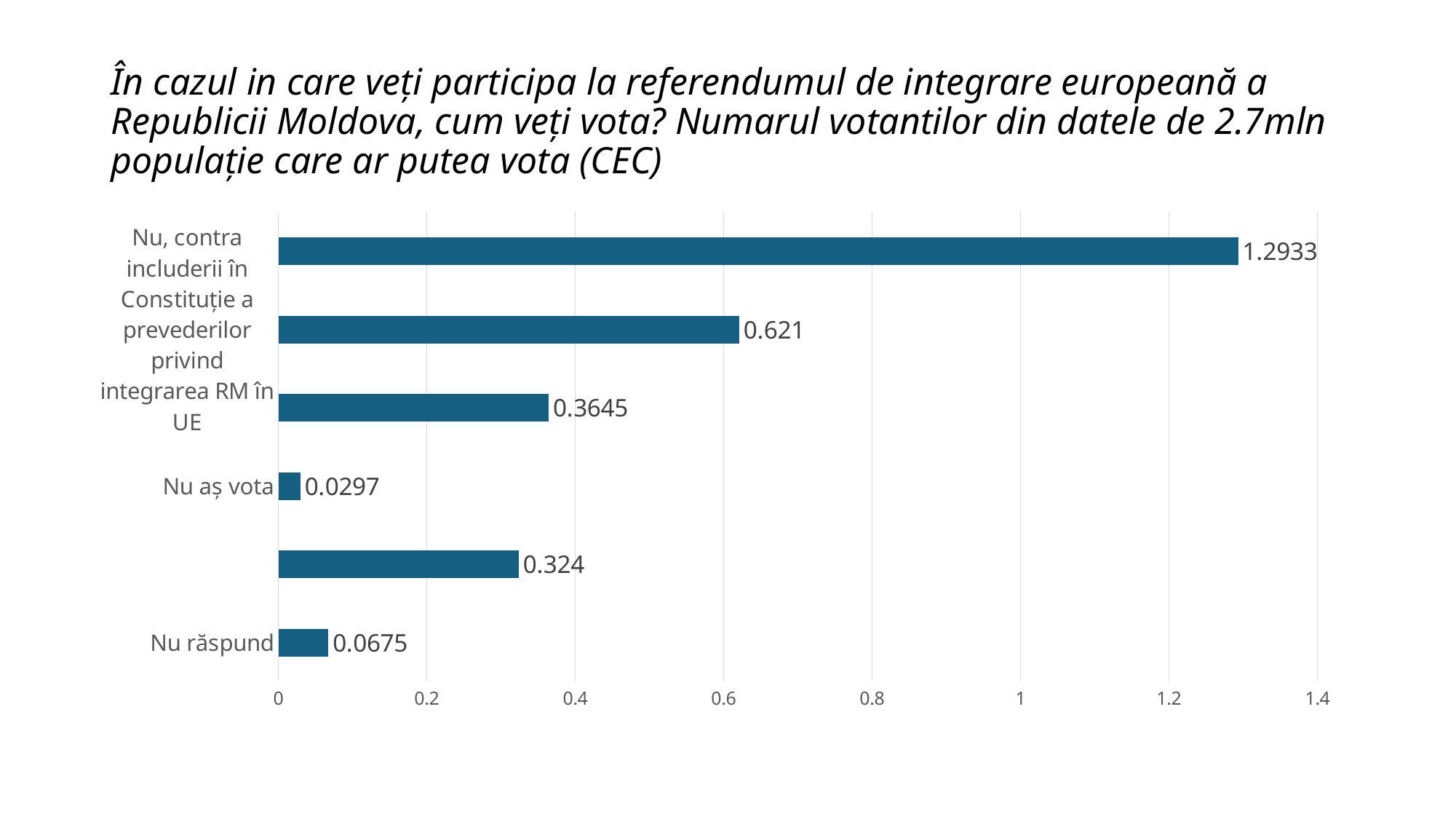
Is the value of the topmost bar greater or less than 1.2? greater What is the difference between the values for "Nu răspund" and "Nu aș vota"? 0.0378 What is the value for "Nu aș vota"? 0.0297 How many bars are plotted in the chart? 6 What kind of chart is shown on the slide? bar chart What is the value for "Nu răspund"? 0.0675 What is the largest value shown in the chart? 1.2933 What is the highest tick value shown on the x axis? 1.4 What is the value of the second bar from the top? 0.621 Which category has the smallest value? Nu aș vota Which is larger, the value for "Nu răspund" or the value for "Nu aș vota"? Nu răspund What is the value of the topmost bar in the chart? 1.2933